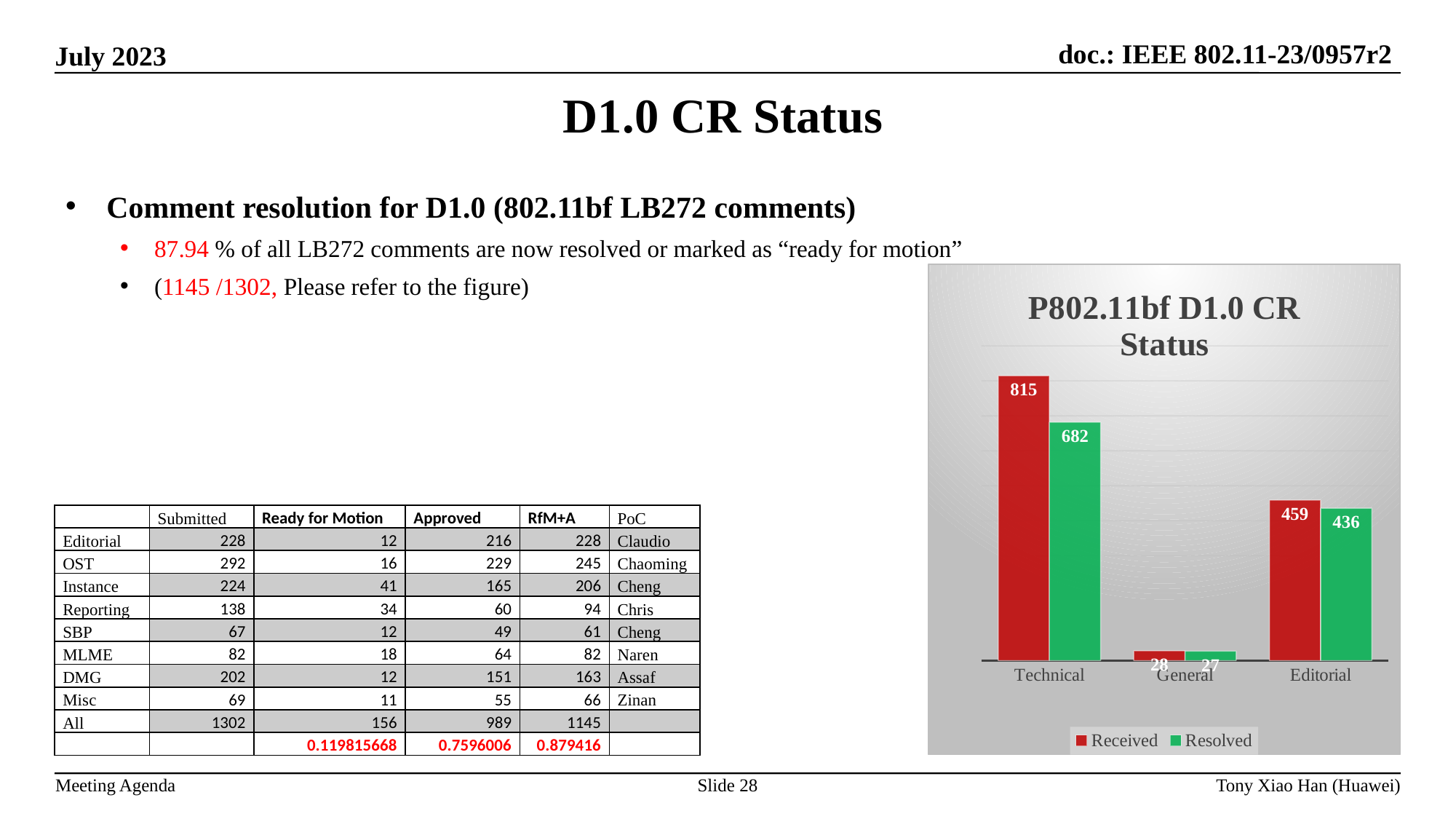
What is the Resolved value for General? 27 Which category has the highest Received value? Technical What is the difference between Received and Resolved for Editorial? 23 How many categories are shown on the x axis? 3 What is the difference between Received and Resolved for Technical? 133 What is the title of the chart? P802.11bf D1.0 CR Status What kind of chart is shown? bar chart What is the Received value for Technical? 815 Which category has the lowest Resolved value? General What is the Resolved value for Editorial? 436 Which is larger, the Resolved value for Technical or the Received value for Editorial? Resolved value for Technical How many series does the legend list? 2